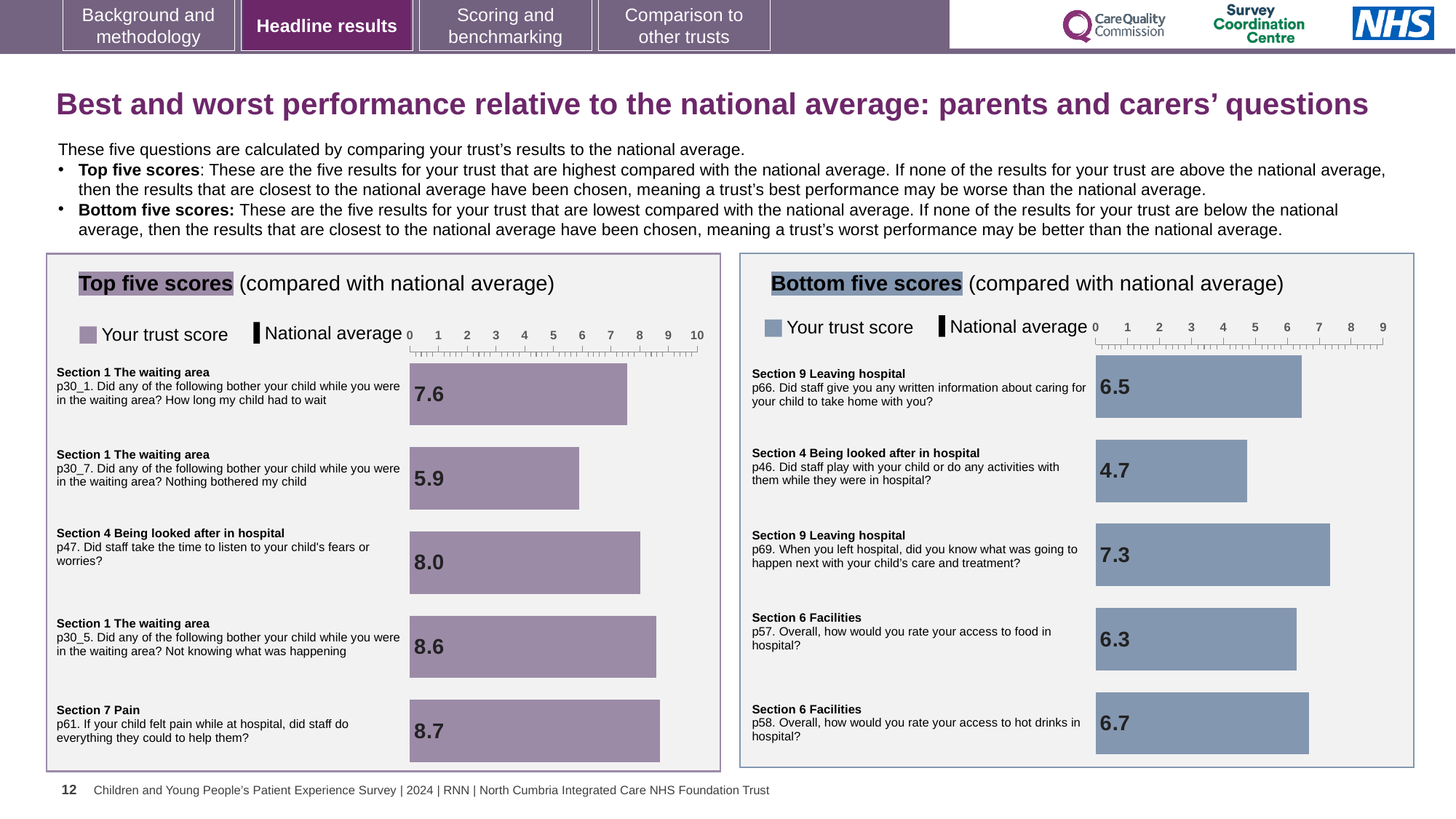
In the Top five scores chart, what is the difference between the trust scores for p61 and p30_7? 2.8 In the Bottom five scores chart, what is the difference between the trust scores for p69 and p46? 2.6 In the Top five scores chart, what is the trust score for p30_7 (Nothing bothered my child)? 5.9 In the Bottom five scores chart, which question has the highest trust score? p69 (Section 9 Leaving hospital) In the Top five scores chart, which question has the highest trust score? p61 (Section 7 Pain) In the Top five scores chart, what is the trust score for p61 (If your child felt pain while at hospital, did staff do everything they could to help them?)? 8.7 In the Bottom five scores chart, what is the trust score for p58 (access to hot drinks in hospital)? 6.7 In the Bottom five scores chart, what is the trust score for p46 (Did staff play with your child or do any activities with them while they were in hospital?)? 4.7 In the Bottom five scores chart, which has the larger trust score: p66 (written information to take home) or p57 (access to food)? p66 What kind of chart is the Top five scores chart? Bar chart How many questions are shown in the Bottom five scores chart? 5 In the Bottom five scores chart, which question has the lowest trust score? p46 (Section 4 Being looked after in hospital)